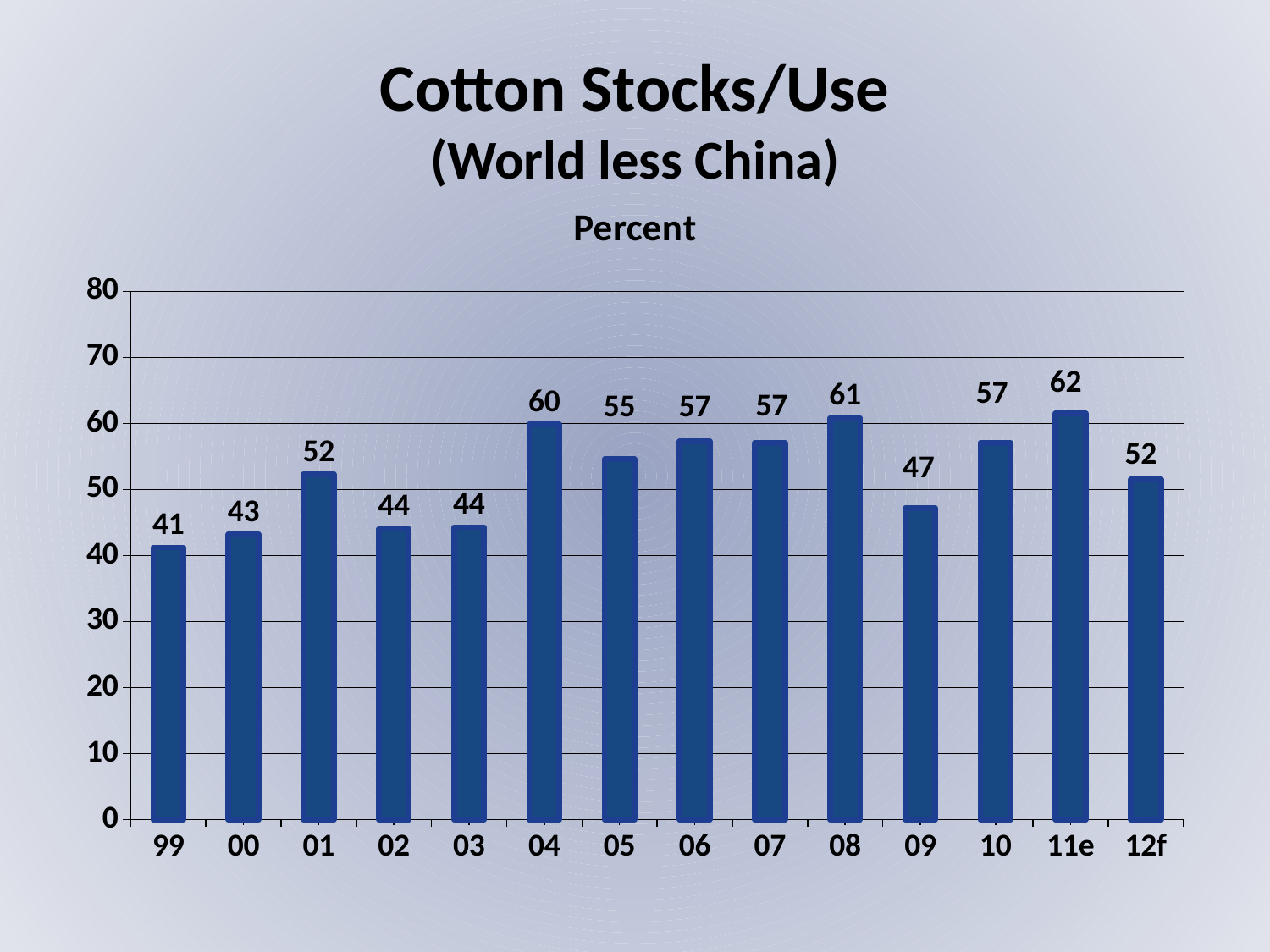
Which year has the highest stocks/use value? 11e What is the value shown for 11e? 62 Which is larger, the value for 04 or the value for 05? 04 Which year has the lowest stocks/use value? 99 How many years are shown on the x axis? 14 What is the value shown for 09? 47 Is the value for 12f greater or less than 50? greater Do the values rise or fall from 99 to 01? rise What is the title of the chart? Cotton Stocks/Use (World less China) What is the difference between the values for 08 and 09? 14 What kind of chart is shown on the slide? bar chart What is the cotton stocks/use value for 99? 41